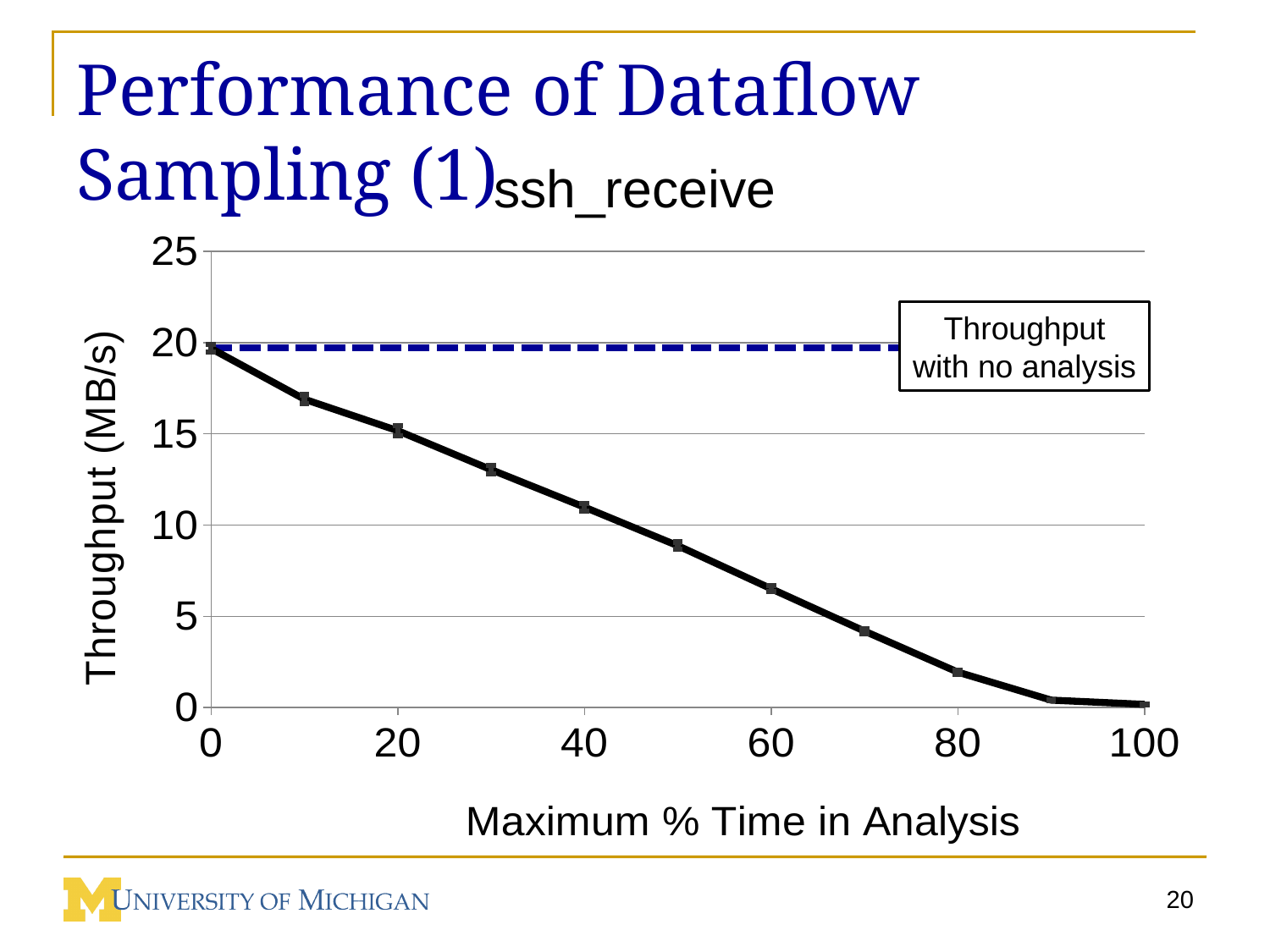
Is the throughput at 80% Maximum Time in Analysis greater or less than 5? less Which has the higher throughput: 20% or 60% Maximum Time in Analysis? 20% How many data points are plotted on the solid throughput line? 11 What kind of chart is shown on the slide? line chart Is the dashed 'Throughput with no analysis' line greater or less than 15? greater Does throughput rise or fall as Maximum % Time in Analysis increases? fall Is the throughput at 30% Maximum Time in Analysis greater or less than 15? less What is the label of the y axis? Throughput (MB/s) At which Maximum % Time in Analysis value is throughput highest? 0 What is the title of the chart? ssh_receive